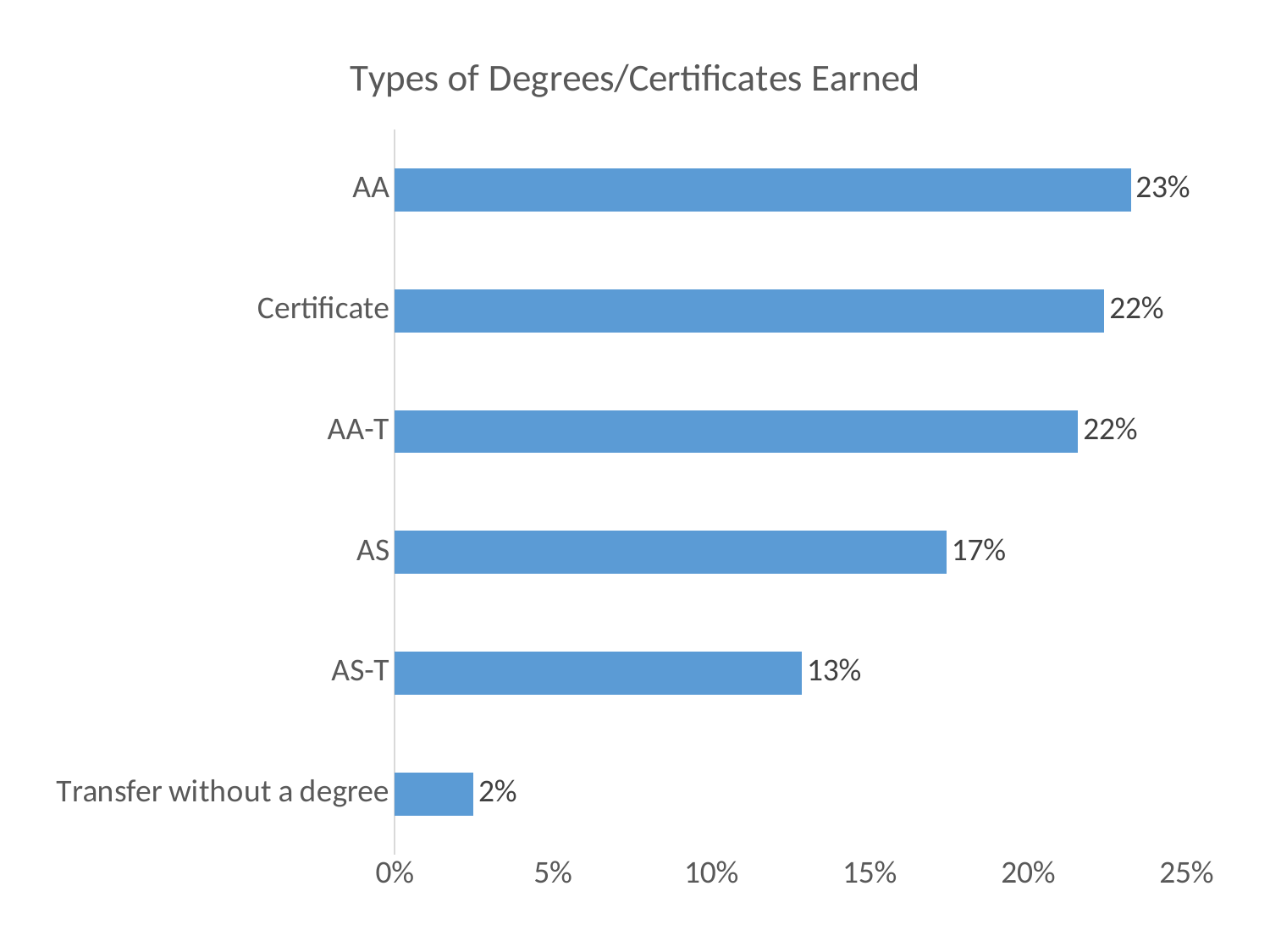
How many categories are shown in the chart? 6 Which is larger, the value for AS or the value for Transfer without a degree? AS What is the value for AA? 23% Is the value for AA-T greater or less than 20%? greater What is the value for AS? 17% Which category has the highest value? AA Which category has the lowest value? Transfer without a degree What kind of chart is this? bar chart What is the title of the chart? Types of Degrees/Certificates Earned What is the value for Transfer without a degree? 2% What is the difference between the values for AS and AS-T? 4% What is the value for AS-T? 13%